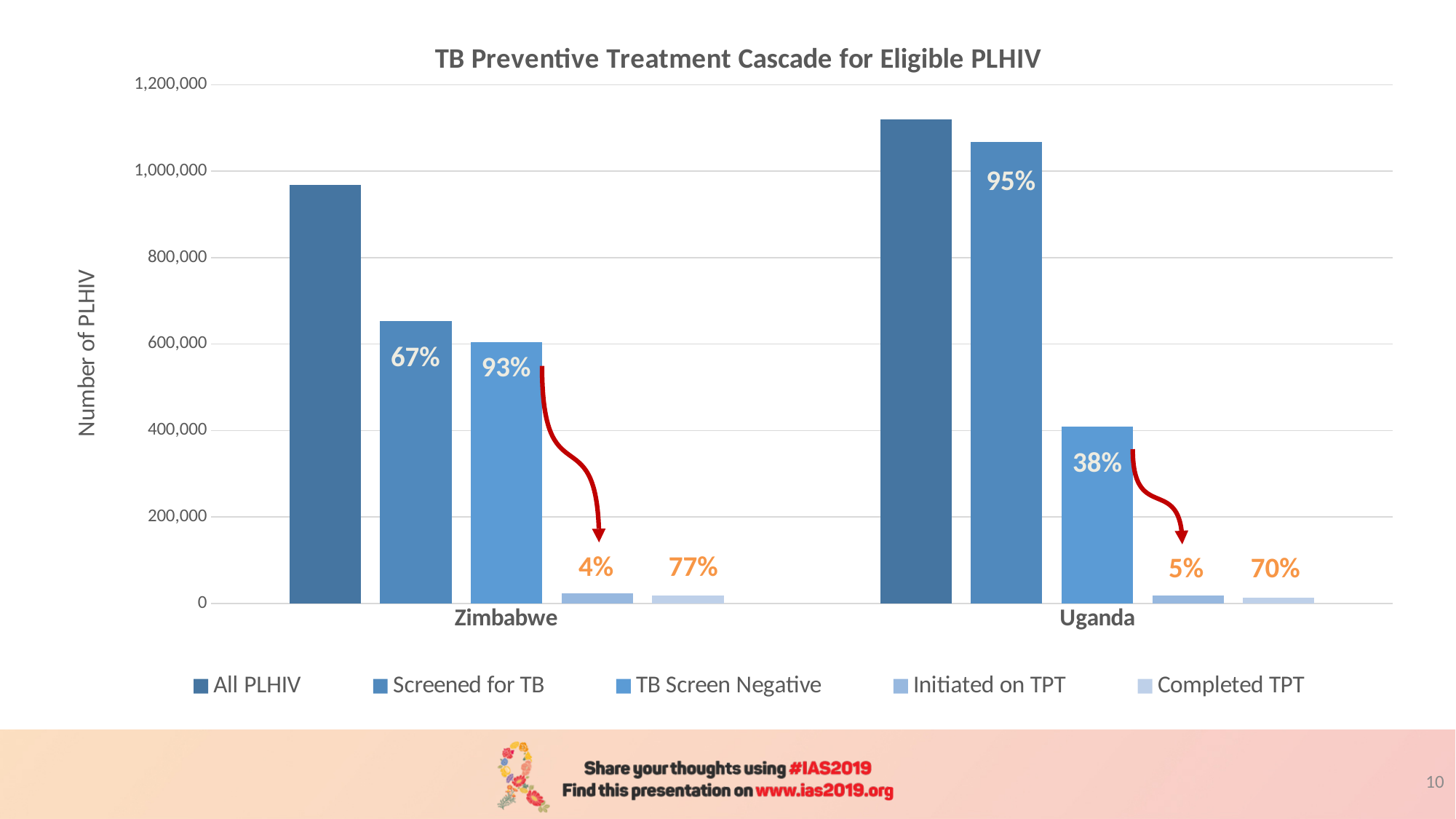
What percentage label is printed above the Completed TPT bar for Uganda? 70% Which series has the lowest value for Uganda? Completed TPT What kind of chart is shown on the slide? bar chart What is the label on the y axis? Number of PLHIV What percentage label is printed on the Screened for TB bar for Zimbabwe? 67% Which country has the larger All PLHIV value, Zimbabwe or Uganda? Uganda What percentage label is printed above the Initiated on TPT bar for Zimbabwe? 4% Is the Screened for TB value for Zimbabwe greater or less than 600,000? greater What percentage label is printed on the TB Screen Negative bar for Uganda? 38% How many countries are shown on the x axis? 2 How many series does the legend list? 5 Is the All PLHIV value for Uganda greater or less than 1,000,000? greater